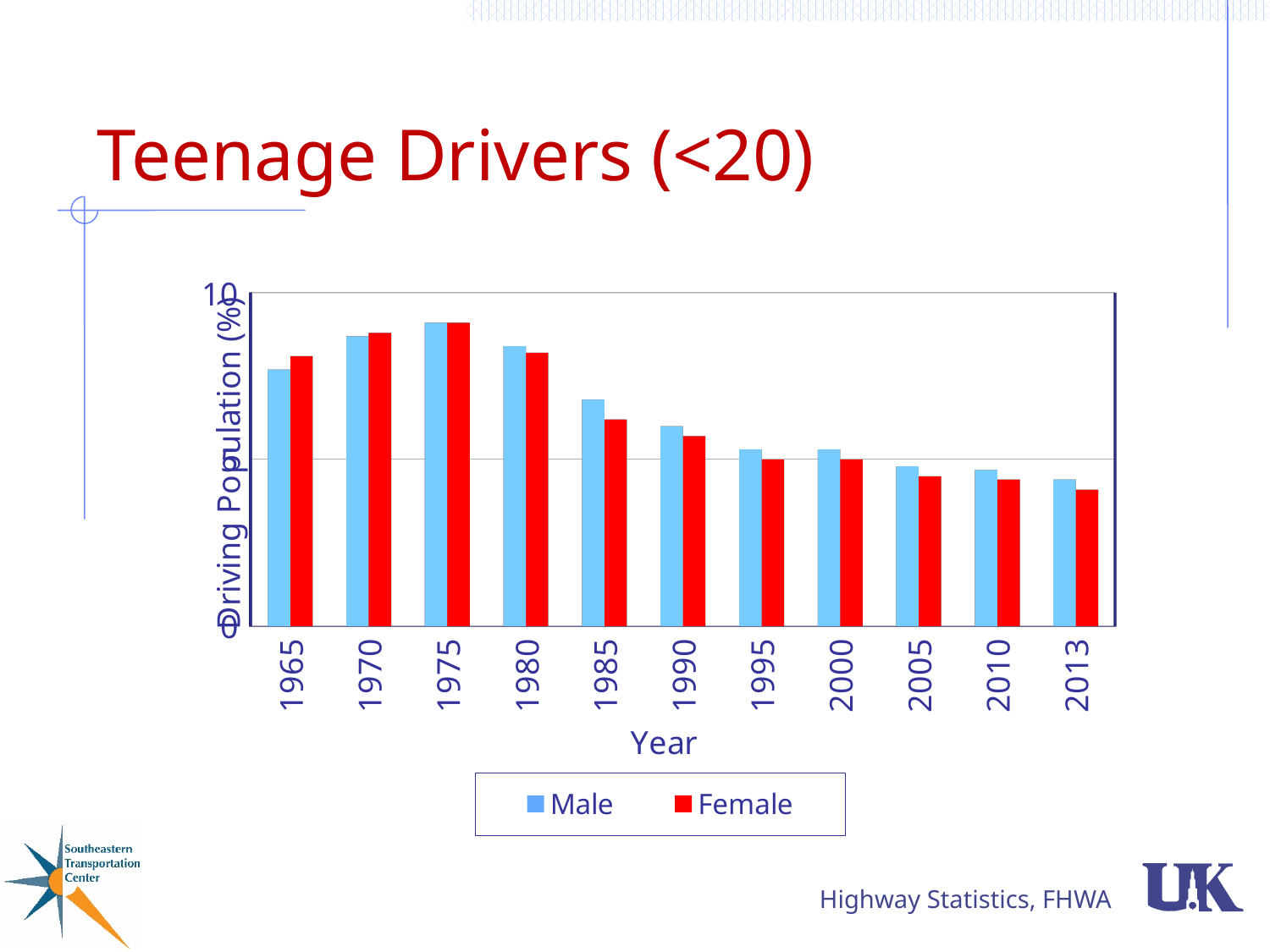
In which year is the Male value highest? 1975 In 1965, which is larger, the Male value or the Female value? Female Is the Female value for 2005 greater or less than 5? less How many series does the legend list? 2 In which year is the Female value highest? 1975 Is the Male value for 1965 greater or less than 5? greater How many years are shown on the x axis? 11 In 1985, which is larger, the Male value or the Female value? Male In which year is the Male value lowest? 2013 Is the Male value for 2013 greater or less than 5? less What kind of chart is shown on the slide? bar chart From 1975 to 2013, do the Male values rise or fall? fall